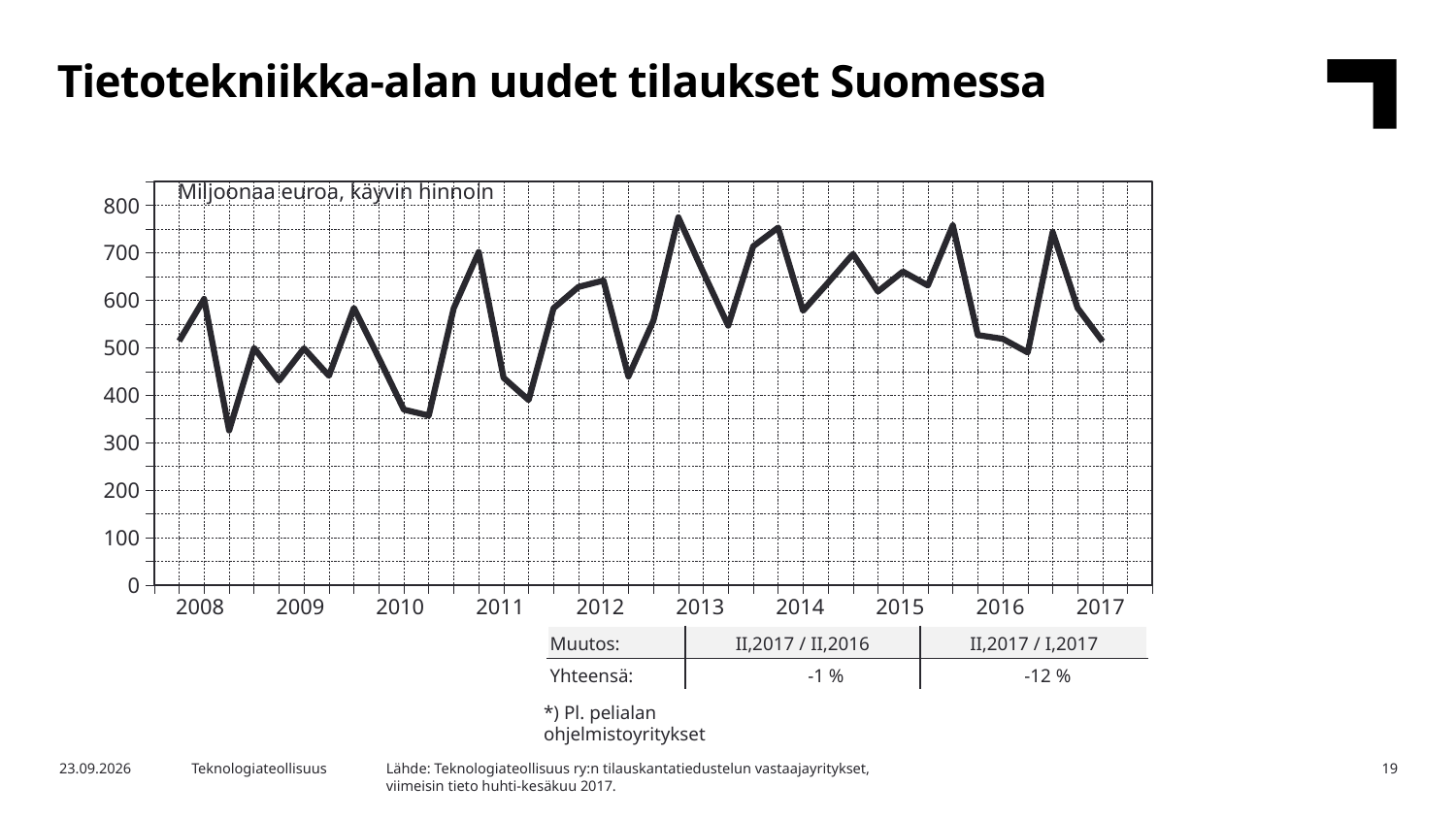
What is the first year labelled on the x axis? 2008 What is the highest value shown on the y axis of the chart? 800 What is the title of the chart on the slide? Tietotekniikka-alan uudet tilaukset Suomessa What is the last year labelled on the x axis? 2017 In which year does the line reach its lowest point? 2008 Is the lowest point of the line in 2010 greater or less than 400? less Is the lowest point of the line, in 2008, greater or less than 400? less What kind of chart is shown on the slide? Line chart What unit is the chart's vertical axis measured in, according to the label inside the plot area? Miljoonaa euroa, käyvin hinnoin How many years are labelled on the x axis of the chart? 10 Does the line rise or fall from the peak in 2016 to the last point in 2017? Fall Is the value at the last plotted point in 2017 greater or less than 500? greater